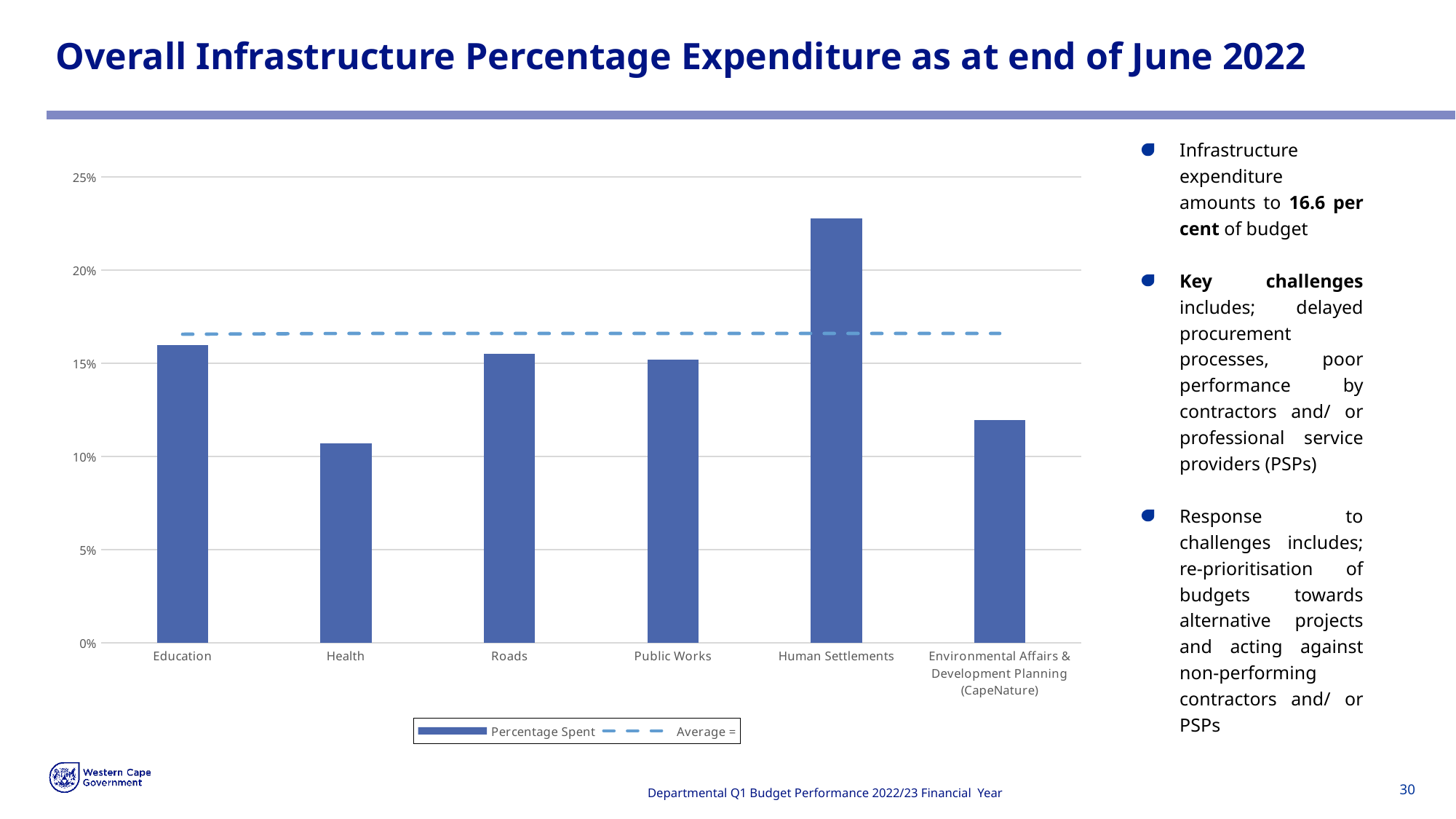
Which category has the lowest percentage spent? Health What kind of chart is shown on the slide? combination bar and line chart Which has a higher percentage spent, Health or Environmental Affairs & Development Planning (CapeNature)? Environmental Affairs & Development Planning (CapeNature) Which category has the highest percentage spent? Human Settlements Is the value for Health greater or less than 15%? less Is the value for Human Settlements greater or less than 20%? greater What does the dashed line in the chart represent, according to the legend? Average = How many categories are shown on the x axis of the chart? 6 Which has a higher percentage spent, Human Settlements or Education? Human Settlements Is the value for Environmental Affairs & Development Planning (CapeNature) greater or less than 15%? less How many series does the chart legend list? 2